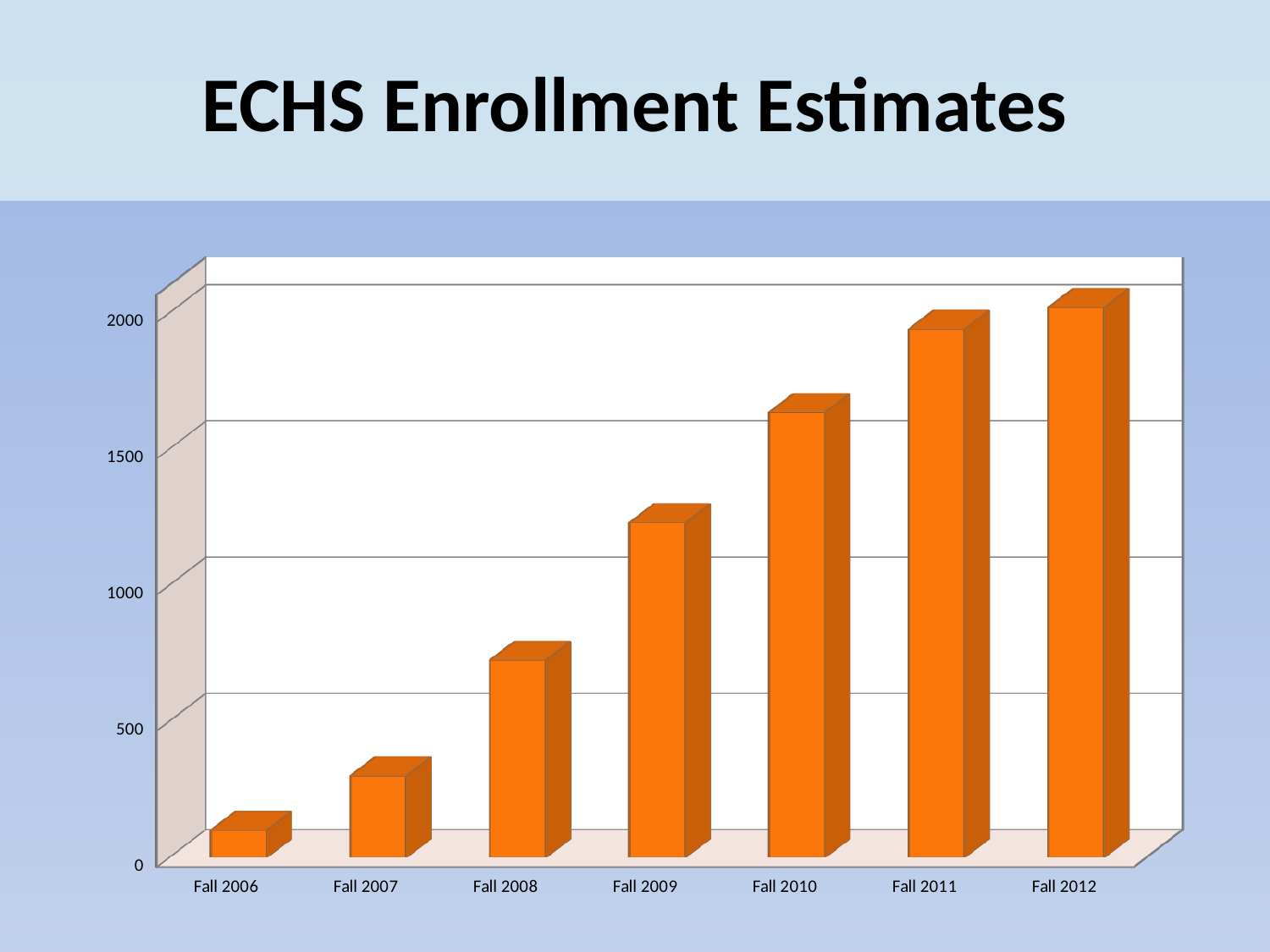
Which is larger, the value for Fall 2009 or the value for Fall 2008? Fall 2009 Which category has the lowest value? Fall 2006 Which category has the highest value? Fall 2012 What kind of chart is shown on the slide? bar chart Is the value for Fall 2010 greater or less than 1500? greater Is the value for Fall 2007 greater or less than 500? less How many categories are shown on the x axis? 7 Is the value for Fall 2009 greater or less than 1000? greater What is the title of the chart? ECHS Enrollment Estimates Do the values rise or fall from Fall 2006 to Fall 2012? rise